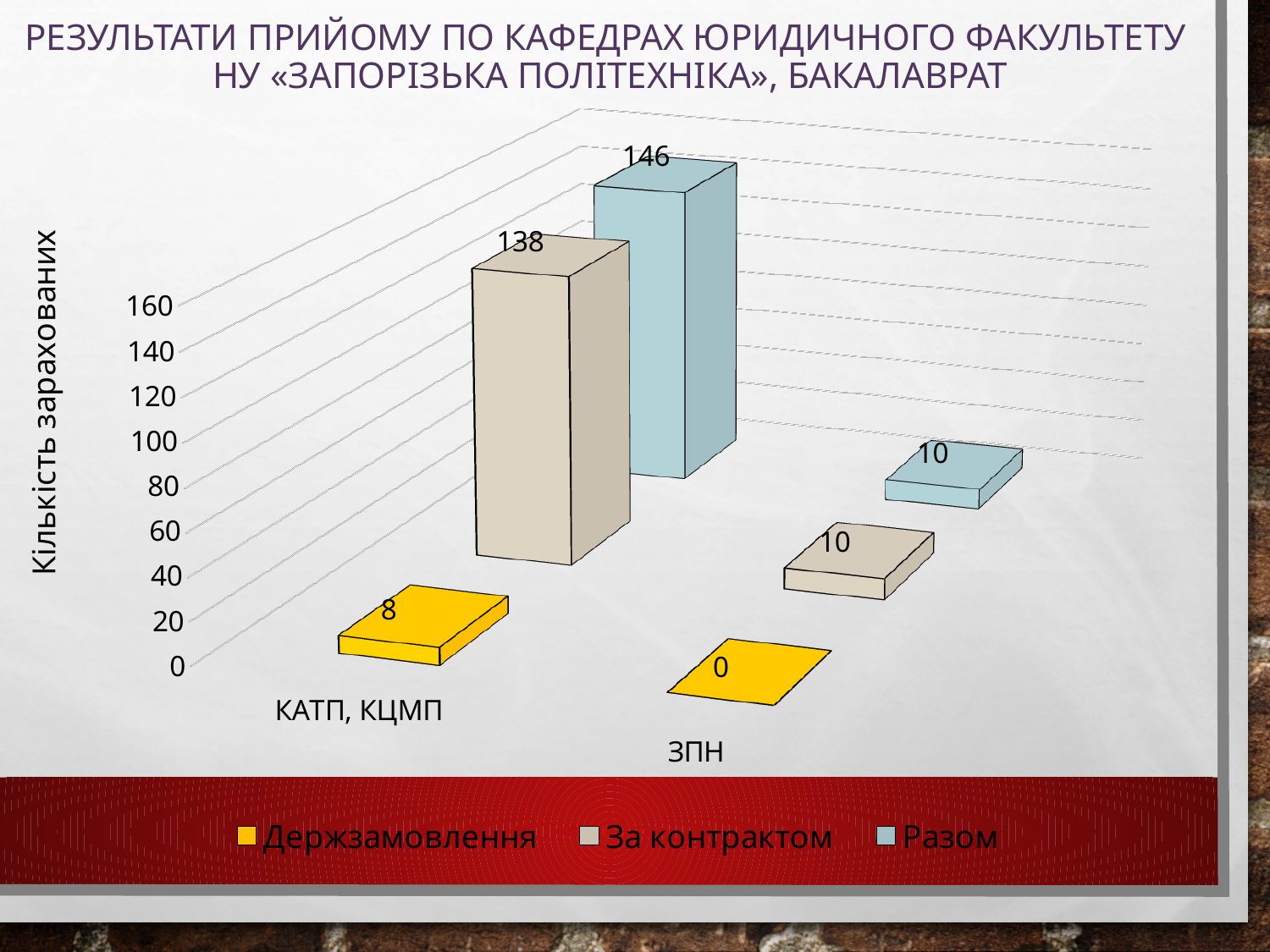
What is the value of Разом for КАТП, КЦМП? 146 How many categories are shown on the x axis? 2 What is the difference between the Разом values for КАТП, КЦМП and ЗПН? 136 Which is larger for КАТП, КЦМП: Держзамовлення or За контрактом? За контрактом What is the value of Держзамовлення for ЗПН? 0 What is the value of За контрактом for КАТП, КЦМП? 138 How many series does the legend list? 3 What is the value of За контрактом for ЗПН? 10 What kind of chart is shown on the slide? Bar chart Which category has the highest Разом value? КАТП, КЦМП Which category has the lowest Держзамовлення value? ЗПН What is the value of Держзамовлення for КАТП, КЦМП? 8